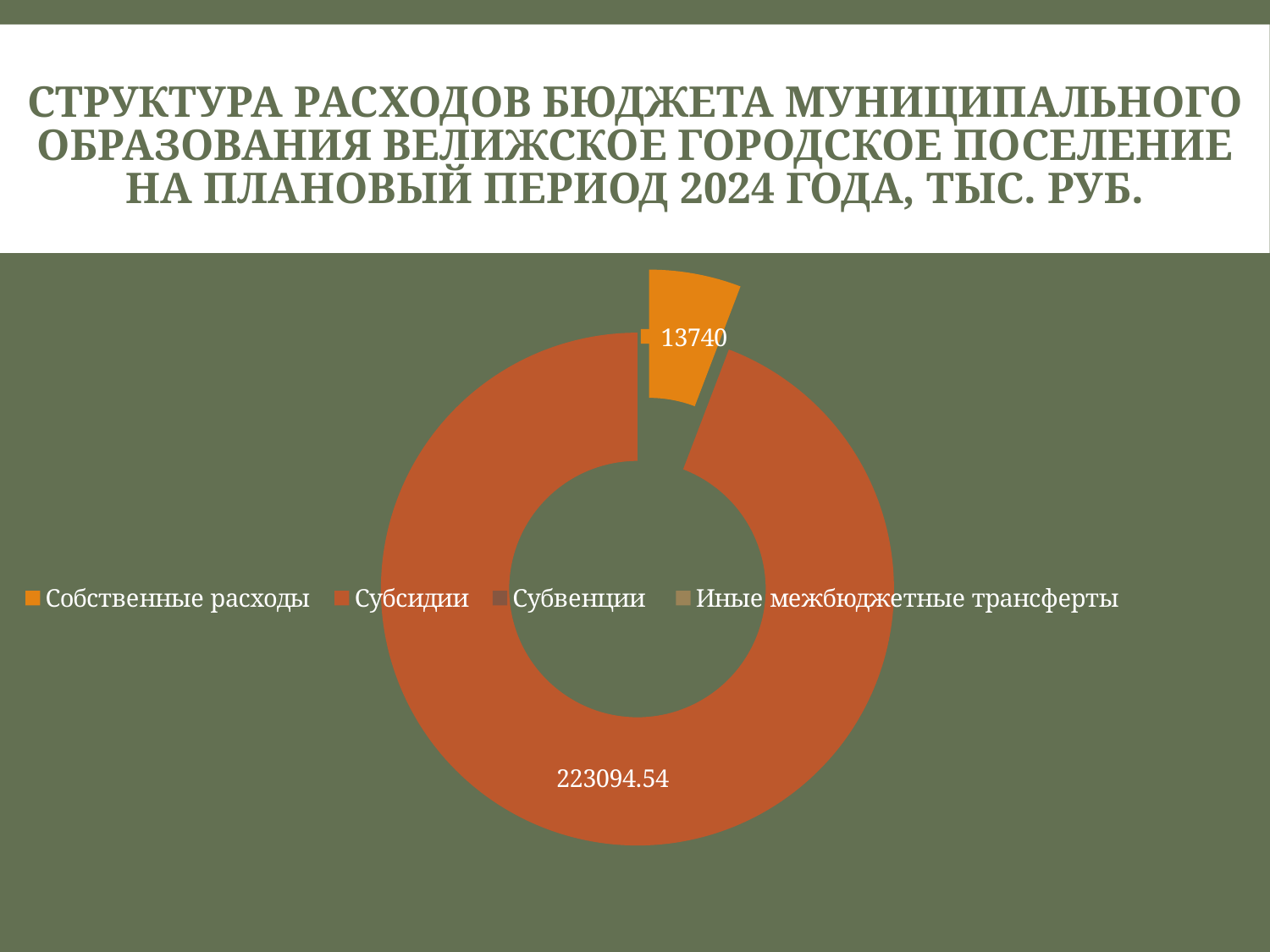
What is the value for Субсидии? 223094.54 How many slices with data labels are visible in the chart? 2 What unit of measurement is stated in the slide title? тыс. руб. What is the total of the two labelled slices, Собственные расходы and Субсидии? 236834.54 What is the difference between the values for Субсидии and Собственные расходы? 209354.54 Which category has the largest slice? Субсидии Which labelled category has the smallest slice? Собственные расходы How many entries does the legend list? 4 What is the value for Собственные расходы? 13740 Which is larger, Собственные расходы or Субсидии? Субсидии What kind of chart is shown on the slide? Doughnut (pie) chart What colour is the slice for Собственные расходы? Orange